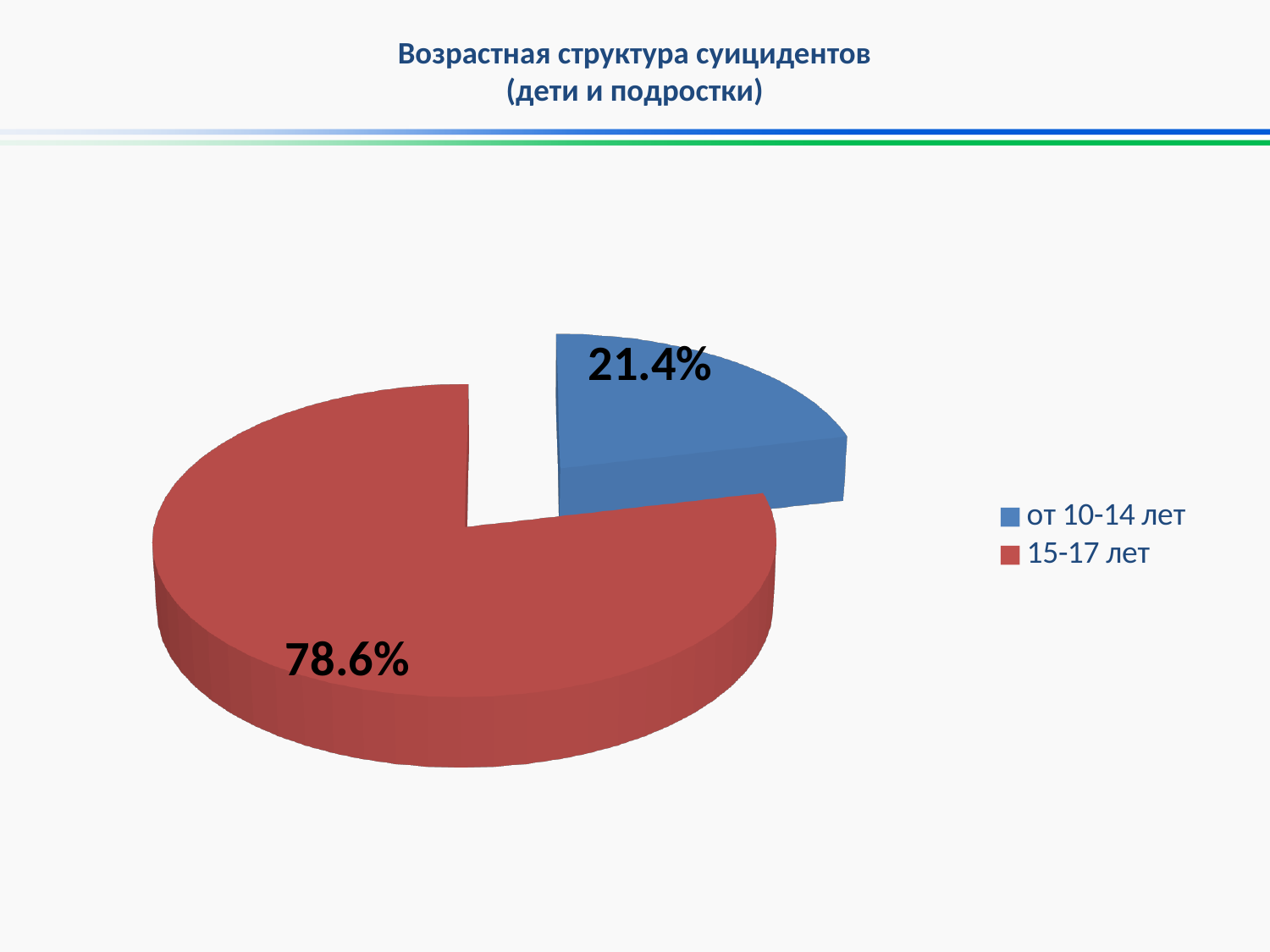
How many entries does the legend list? 2 What share of the pie does the "15-17 лет" slice represent? 78.6% What share of the pie does the "от 10-14 лет" slice represent? 21.4% How many slices does the pie chart have? 2 What kind of chart is shown on the slide? Pie chart Which age group has the largest share of the pie? 15-17 лет What is the difference in percentage points between the "15-17 лет" and "от 10-14 лет" slices? 57.2 What is the title of the slide? Возрастная структура суицидентов (дети и подростки) Which age group has the smallest share of the pie? от 10-14 лет Which slice is larger, "от 10-14 лет" or "15-17 лет"? 15-17 лет What colour is the "15-17 лет" slice? Red